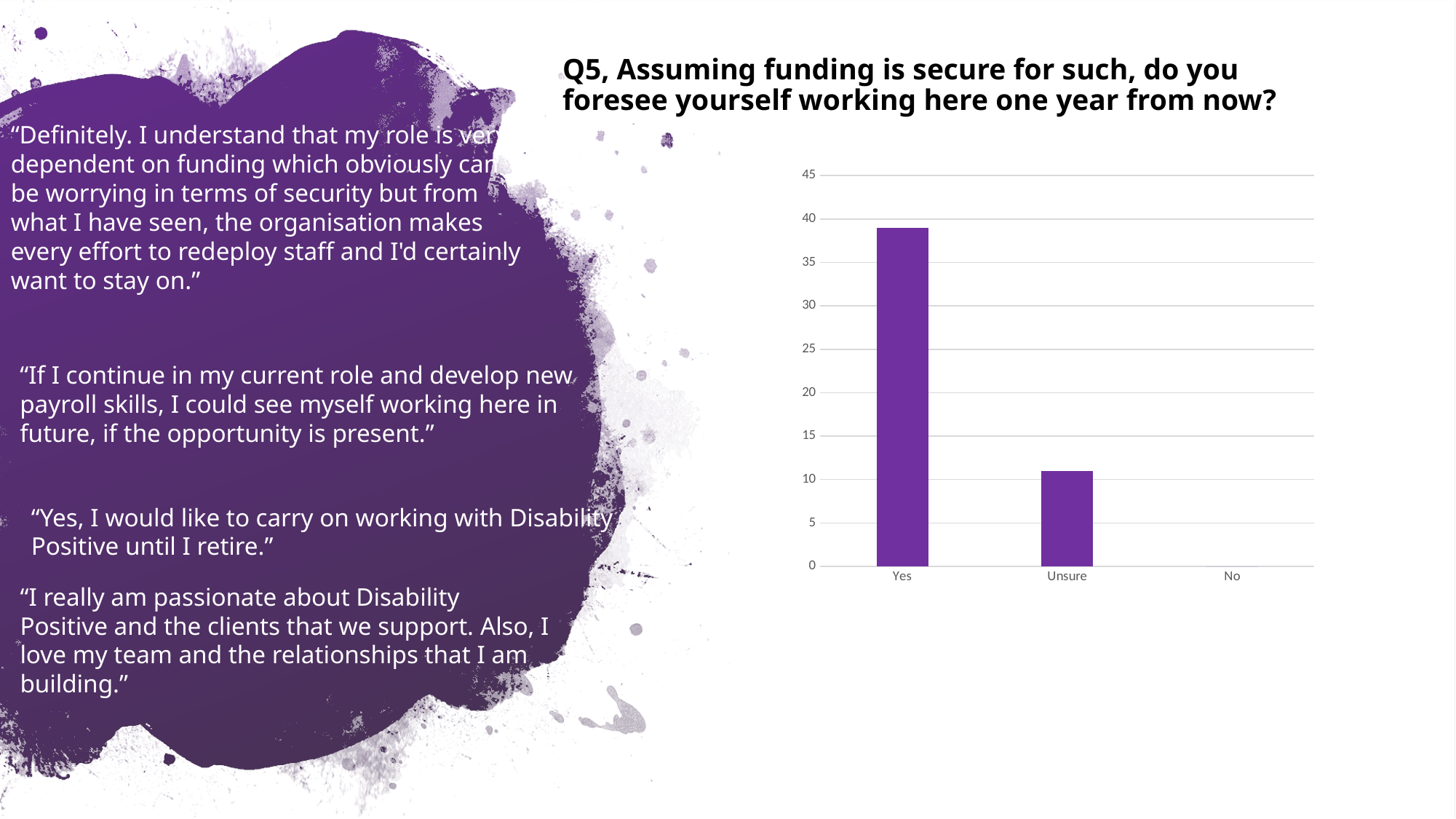
Which is larger, the value for Yes or the value for Unsure? Yes What colour are the bars in the chart? purple What kind of chart is shown on the slide? bar chart Which response category has the lowest value in the chart? No Is the value for Unsure greater or less than 15? less Is the value for Yes greater or less than 35? greater How many response categories are shown on the x axis of the chart? 3 What is the value for No in the chart? 0 What is the title of the chart? Q5, Assuming funding is secure for such, do you foresee yourself working here one year from now? Which response category has the highest value in the chart? Yes